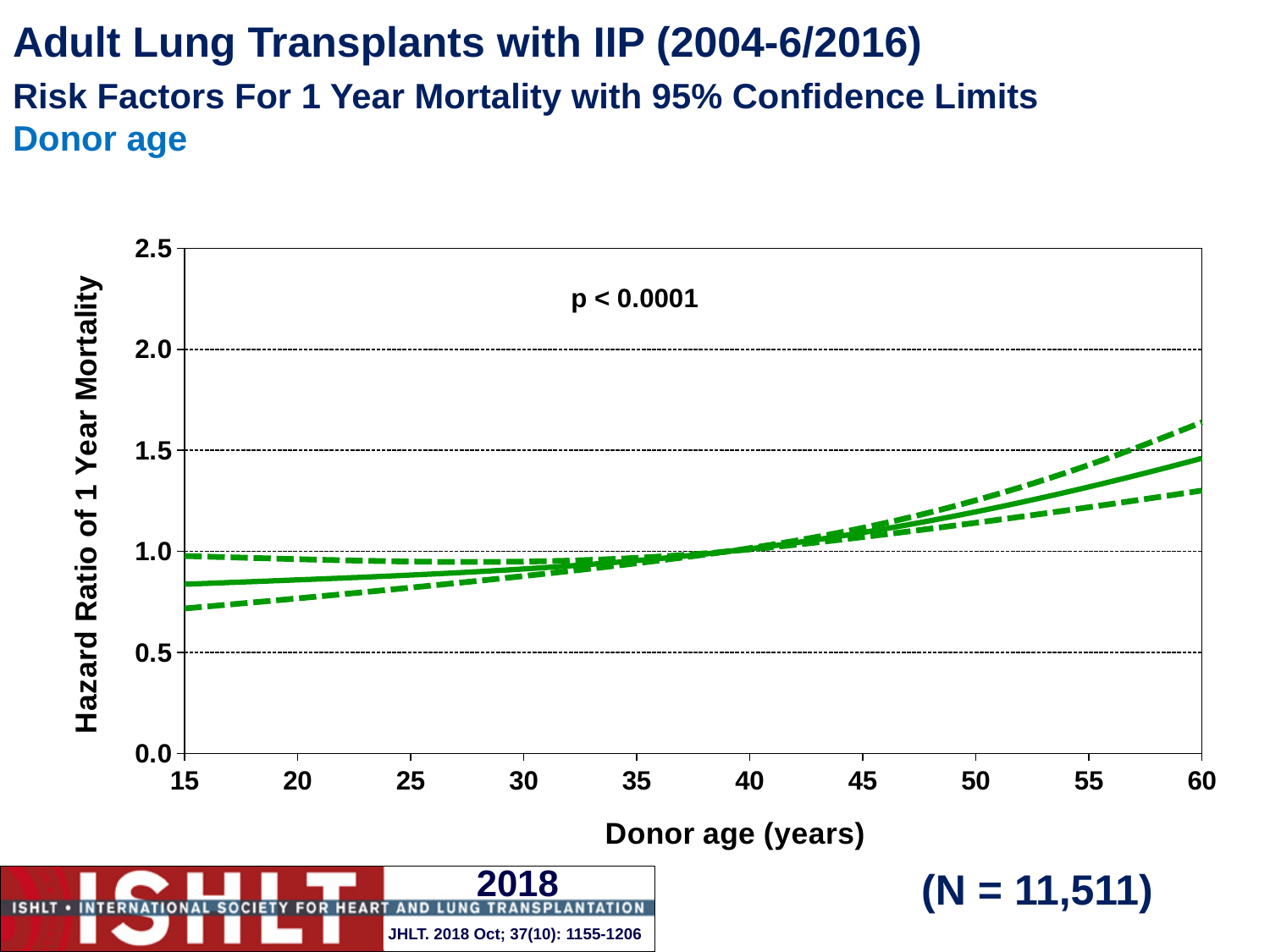
At a donor age of 15 years, is the hazard ratio shown by the solid line greater or less than 1.0? less What is the label of the x axis? Donor age (years) Is the hazard ratio shown by the solid line at donor age 60 larger or smaller than at donor age 15? larger Does the hazard ratio of 1 year mortality rise or fall as donor age increases from 15 to 60 years? rise At a donor age of 50 years, is the hazard ratio shown by the solid line greater or less than 1.0? greater At a donor age of 60 years, is the hazard ratio shown by the solid line greater or less than 1.0? greater How many lines are plotted on the chart? 3 What is the p-value printed on the chart? p < 0.0001 What kind of chart is shown on the slide? line chart